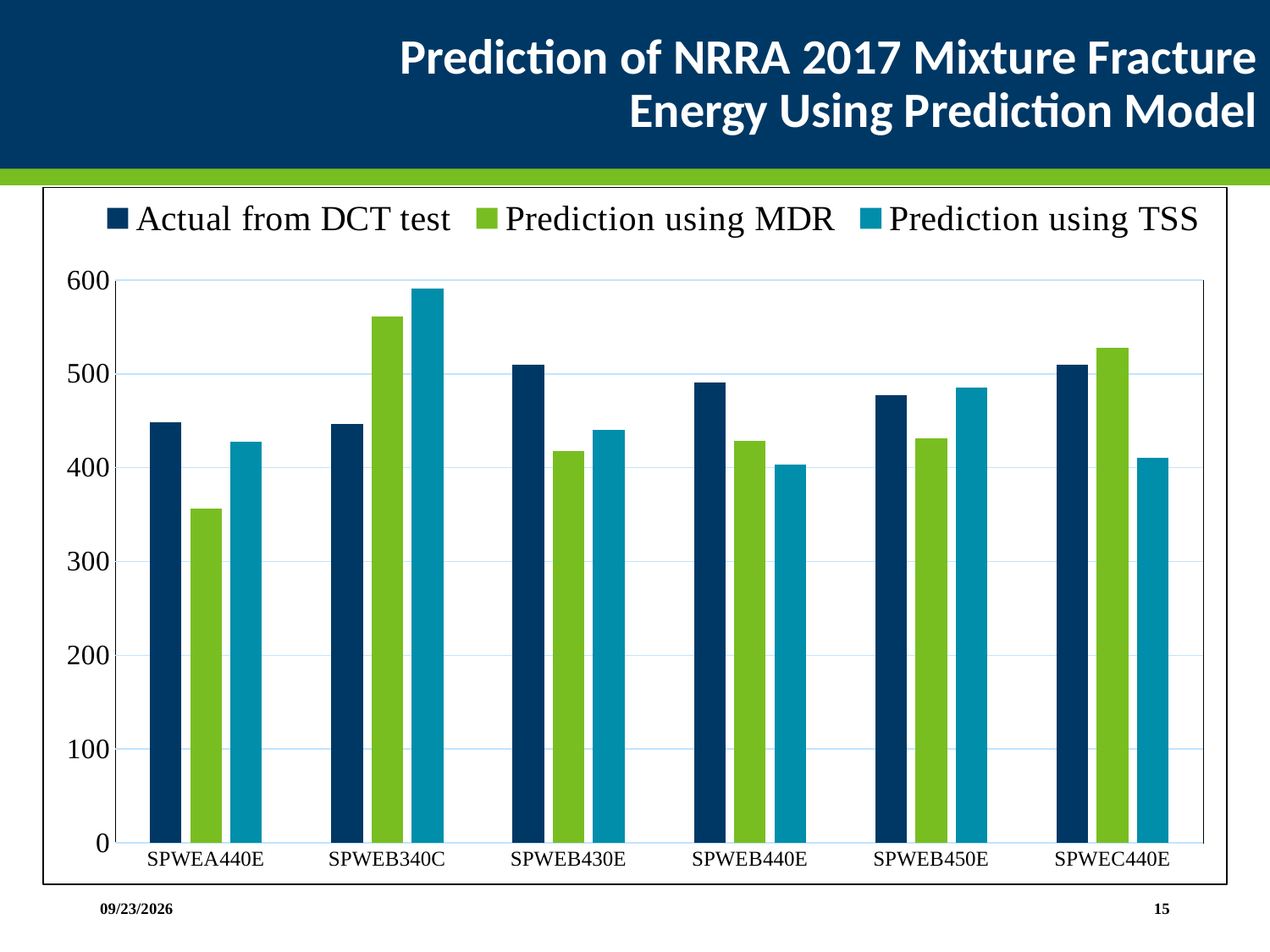
Which series is shown in green in the legend? Prediction using MDR For which mixture is the 'Prediction using TSS' value highest? SPWEB340C Is the 'Prediction using TSS' value for SPWEB340C greater or less than 500? greater What kind of chart is shown on the slide? Bar chart For SPWEA440E, which is larger: 'Actual from DCT test' or 'Prediction using MDR'? Actual from DCT test Is the 'Prediction using MDR' value for SPWEA440E greater or less than 400? less Is the 'Prediction using TSS' value for SPWEB440E greater or less than 500? less For which mixture is the 'Prediction using MDR' value lowest? SPWEA440E For SPWEC440E, which is larger: 'Prediction using MDR' or 'Prediction using TSS'? Prediction using MDR For SPWEB340C, which is larger: 'Actual from DCT test' or 'Prediction using MDR'? Prediction using MDR How many series does the legend list? 3 How many mixture categories are shown on the x axis? 6